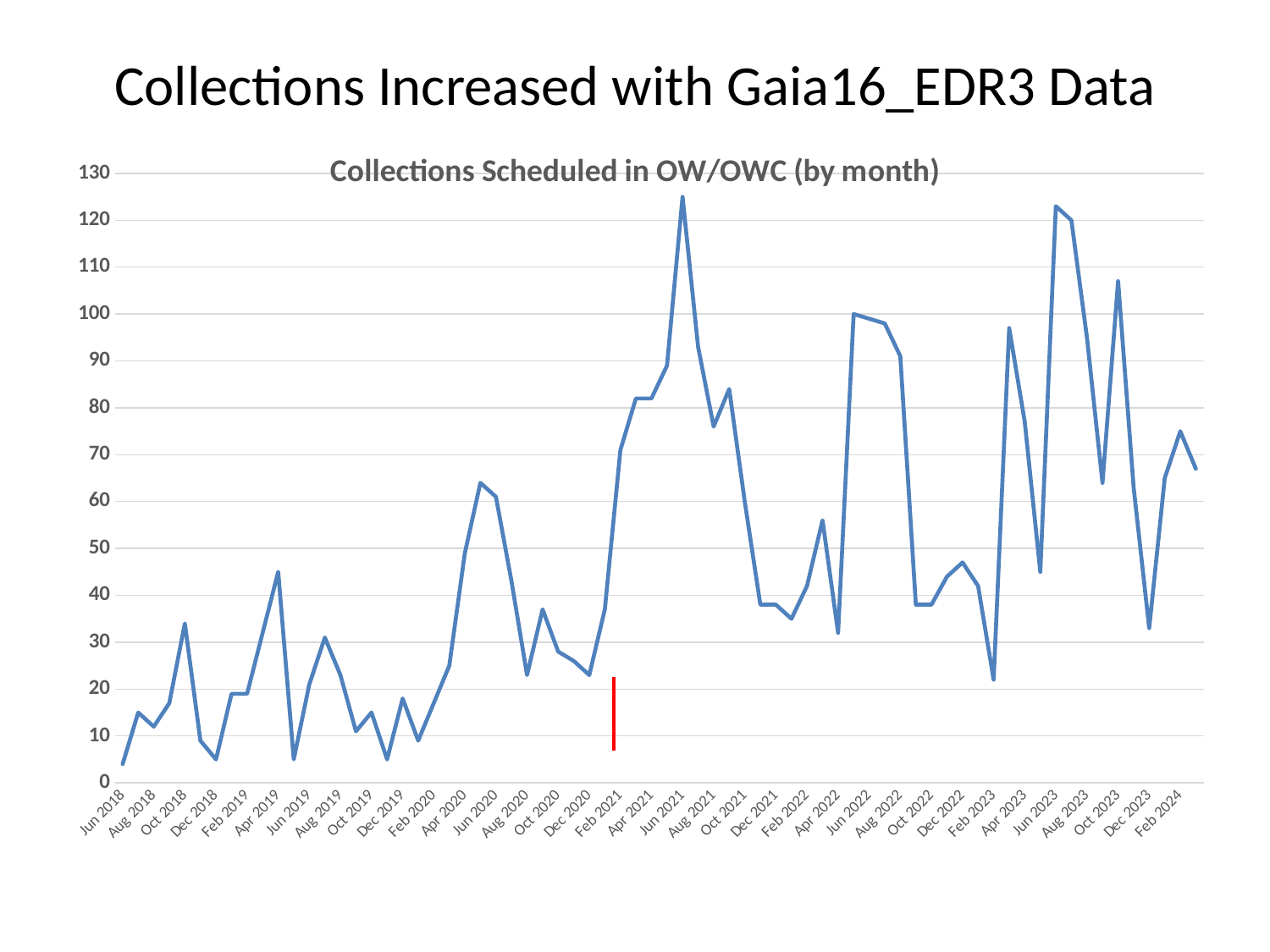
Overall, do the values rise or fall from Jun 2018 to Feb 2024? rise What is the title of the chart? Collections Scheduled in OW/OWC (by month) Which is larger, the value for Apr 2019 or the value for Apr 2020? Apr 2020 Is the value for Jun 2018 greater or less than 10? less Is the value for Feb 2024 greater or less than 60? greater Is the value for Oct 2023 greater or less than 100? greater What kind of chart is shown on the slide? line chart What colour is the vertical marker drawn near Feb 2021 on the chart? red Which is larger, the value for Oct 2018 or the value for Oct 2023? Oct 2023